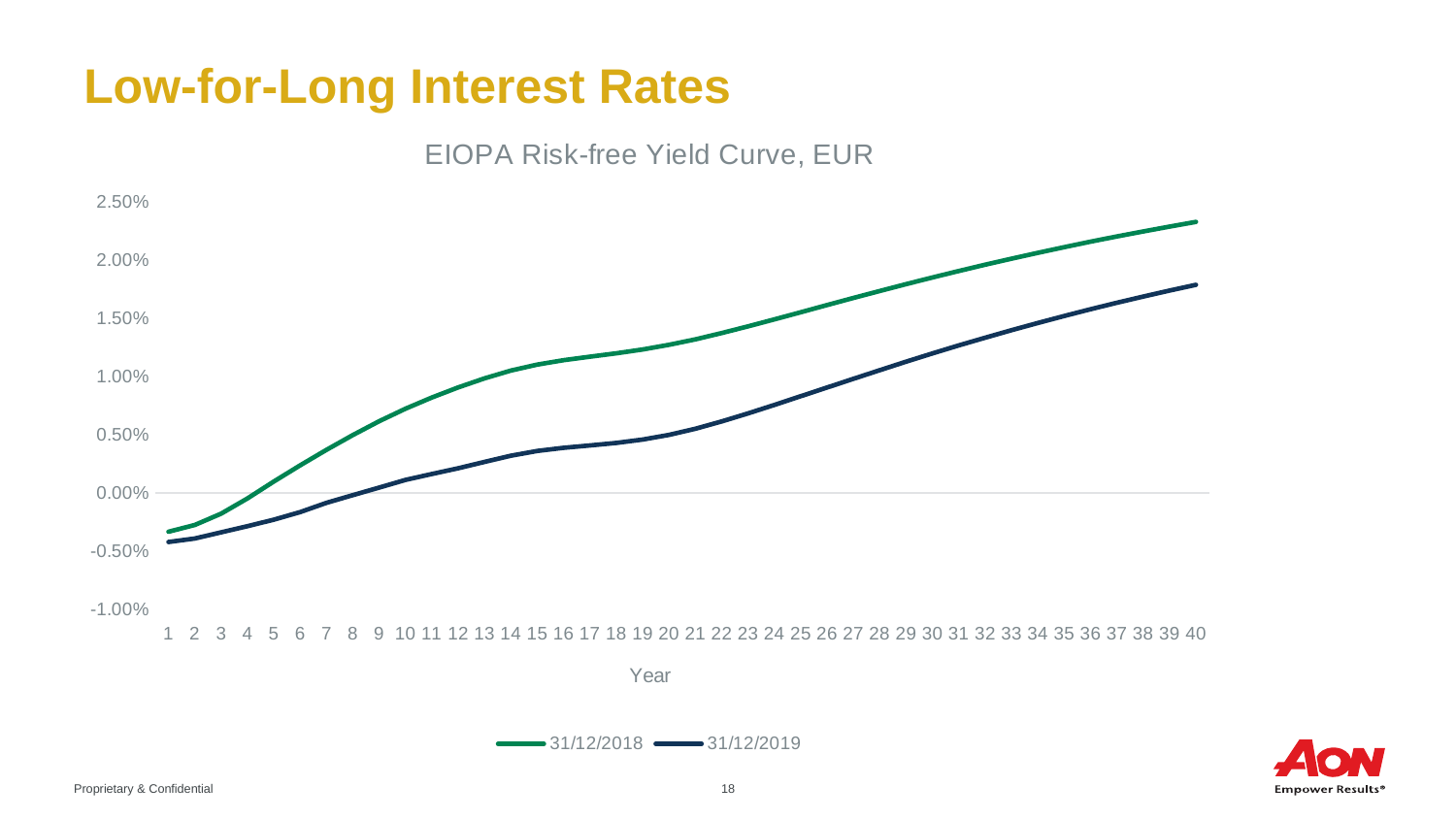
What kind of chart is shown on the slide? line chart What are the two series named in the legend? 31/12/2018 and 31/12/2019 Is the value for 31/12/2019 at year 20 greater or less than 1.00%? less Do the values of the 31/12/2019 series rise or fall as the year increases? rise Which series reaches the highest value on the chart? 31/12/2018 How many years are shown along the x axis? 40 Is the value for 31/12/2018 at year 1 greater or less than 0.00%? less Is the value for 31/12/2019 at year 40 greater or less than 2.00%? less At year 30, which series has the higher value, 31/12/2018 or 31/12/2019? 31/12/2018 How many series does the legend list? 2 What is the title of the chart? EIOPA Risk-free Yield Curve, EUR